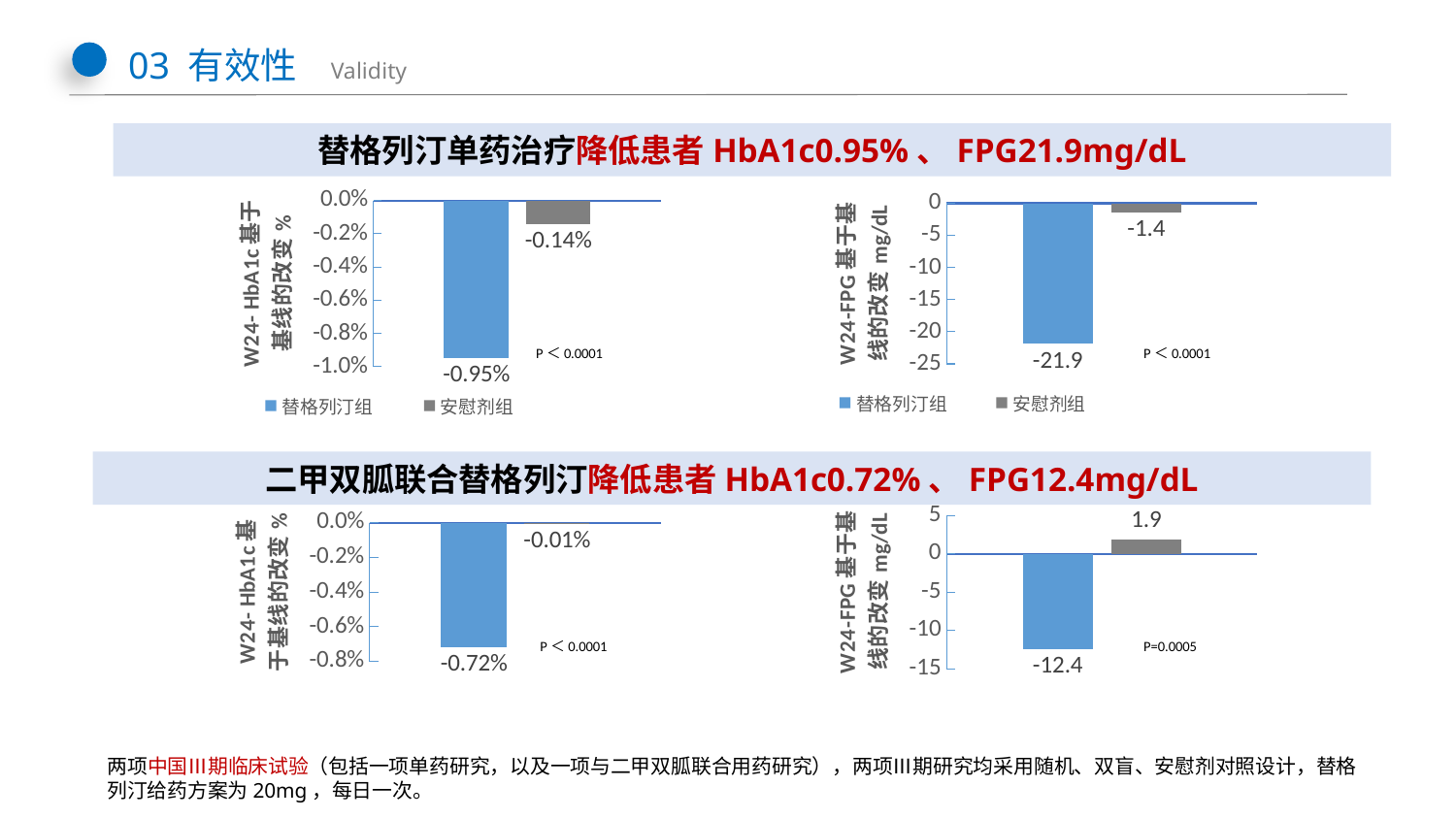
In the bottom-right chart (W24 FPG change, combination with metformin), what is the value shown for the gray bar? 1.9 In the top-left chart (W24 HbA1c change, monotherapy), what is the value for 安慰剂组? -0.14% In the bottom-right chart (W24 FPG change, combination with metformin), is the value for the blue bar greater or less than -10? less What type of chart is the top-right chart (W24 FPG change, monotherapy)? bar chart In the top-right chart (W24 FPG change, monotherapy), what is the value for 替格列汀组? -21.9 In the top-left chart (W24 HbA1c change, monotherapy), what is the value for 替格列汀组? -0.95% In the bottom-left chart (W24 HbA1c change, combination with metformin), what is the value shown for the blue bar? -0.72% What are the two legend entries shown under the top-right chart? 替格列汀组, 安慰剂组 In the top-right chart (W24 FPG change, monotherapy), what is the value for 安慰剂组? -1.4 In the top-right chart (W24 FPG change, monotherapy), what is the difference between the 替格列汀组 and 安慰剂组 values? 20.5 In the top-left chart (W24 HbA1c change, monotherapy), which group shows the larger reduction, 替格列汀组 or 安慰剂组? 替格列汀组 How many series does the legend of the top-left chart list? 2